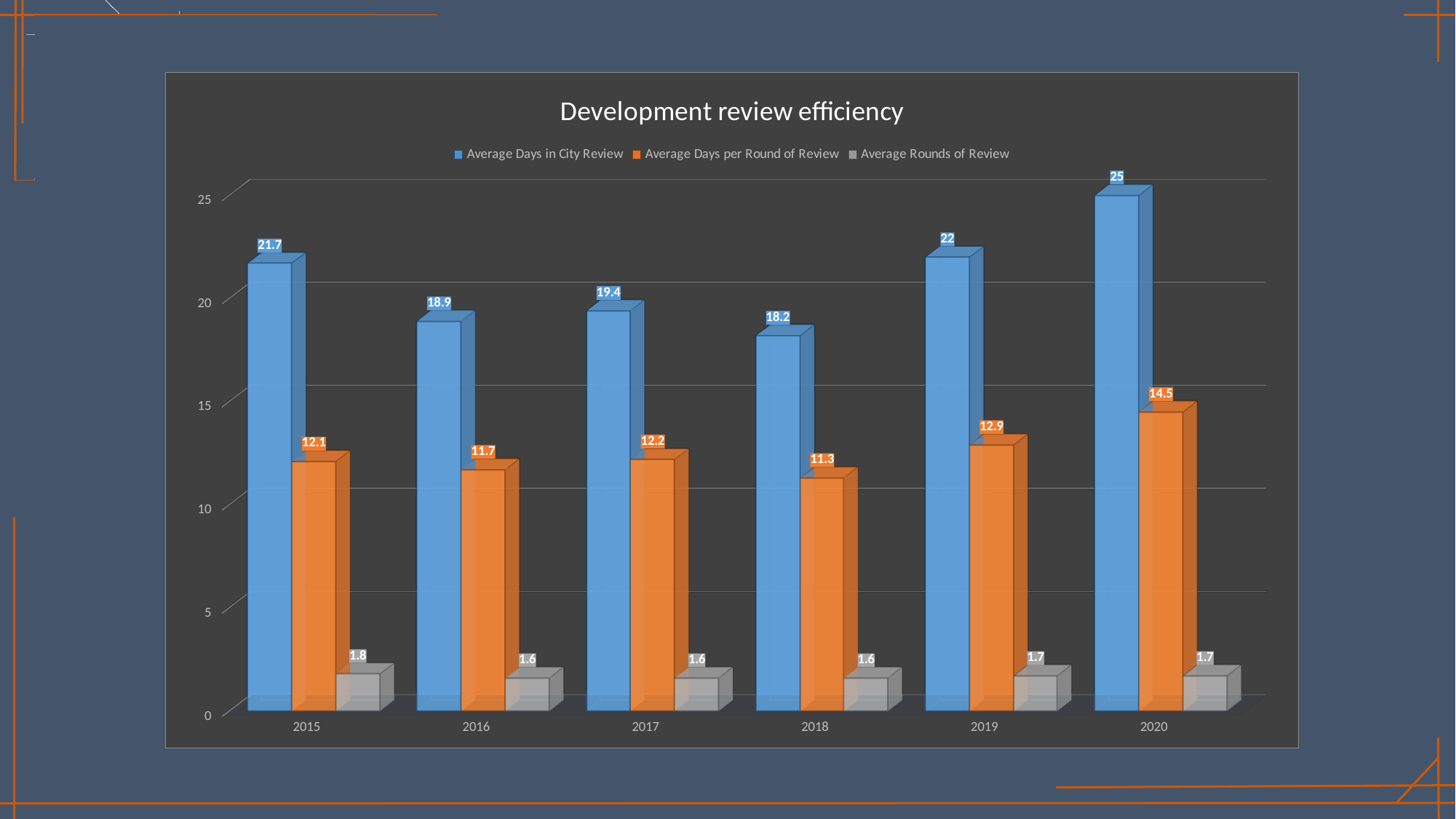
What is the Average Rounds of Review for 2015? 1.8 What is the difference between the Average Days in City Review for 2020 and 2018? 6.8 How many series does the legend list? 3 What is the title of the chart? Development review efficiency What kind of chart is shown on the slide? bar chart How many years are shown on the x axis? 6 Is the Average Days in City Review for 2019 greater or less than 20? greater Which is larger, the Average Days per Round of Review in 2015 or in 2016? 2015 What is the Average Days per Round of Review for 2019? 12.9 Which year has the highest Average Days in City Review? 2020 What is the Average Days in City Review for 2017? 19.4 Which year has the lowest Average Days per Round of Review? 2018